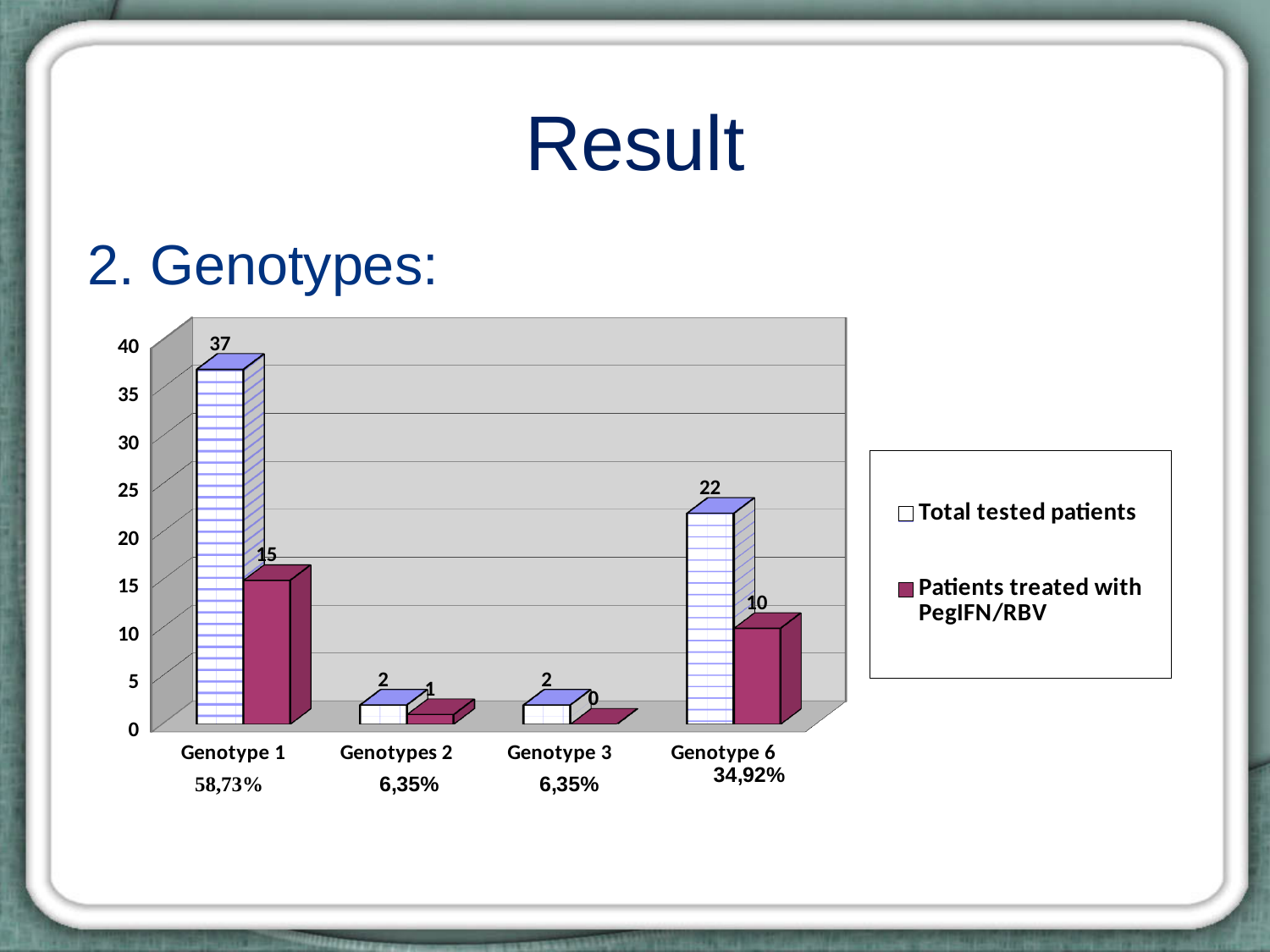
How many series does the legend list? 2 Which genotype has the lowest number of Patients treated with PegIFN/RBV? Genotype 3 What is the difference in Total tested patients between Genotype 1 and Genotype 6? 15 What is the difference between Total tested patients and Patients treated with PegIFN/RBV for Genotype 1? 22 Which genotype has the highest number of Total tested patients? Genotype 1 What percentage is printed below Genotype 6 on the x axis? 34,92% How many genotype categories are shown on the x axis? 4 How many patients treated with PegIFN/RBV are shown for Genotype 6? 10 What kind of chart is shown on the slide? Bar chart What is the value for Total tested patients for Genotype 1? 37 What is the value for Patients treated with PegIFN/RBV for Genotype 3? 0 Which is larger: Patients treated with PegIFN/RBV for Genotype 1 or for Genotype 6? Genotype 1